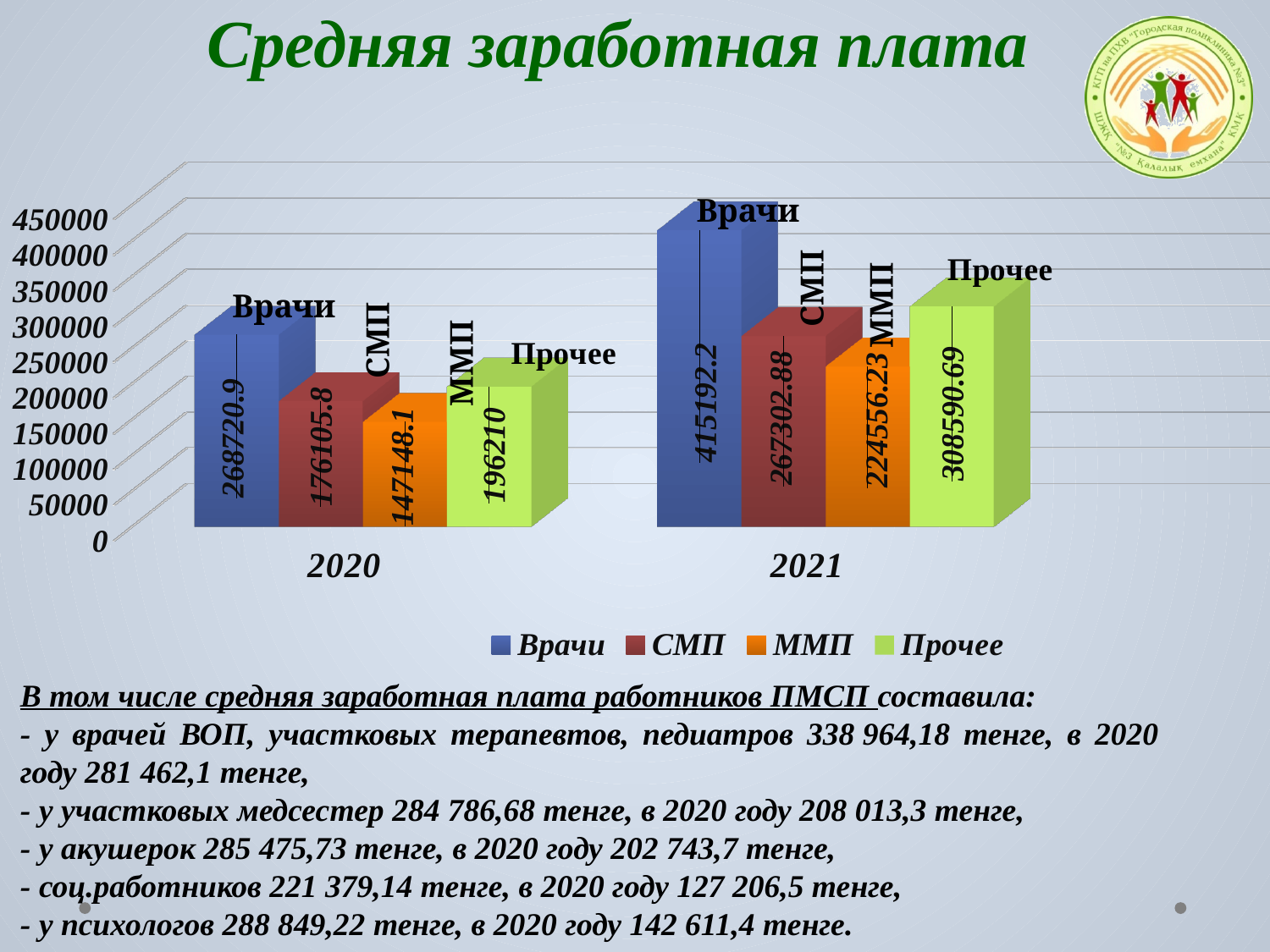
What is the difference between the Врачи values for 2021 and 2020? 146471.3 What is the value for Врачи in 2021? 415192.2 Which is larger: Прочее in 2020 or СМП in 2020? Прочее in 2020 What is the value for Прочее in 2021? 308590.69 What is the title of the slide's chart? Средняя заработная плата What is the value for ММП in 2020? 147148.1 Which series has the highest value in 2021? Врачи How many series does the legend list? 4 What kind of chart is shown on the slide? bar chart Which series has the lowest value in 2020? ММП What is the value for СМП in 2020? 176105.8 Is the value for СМП in 2021 greater or less than 250000? greater